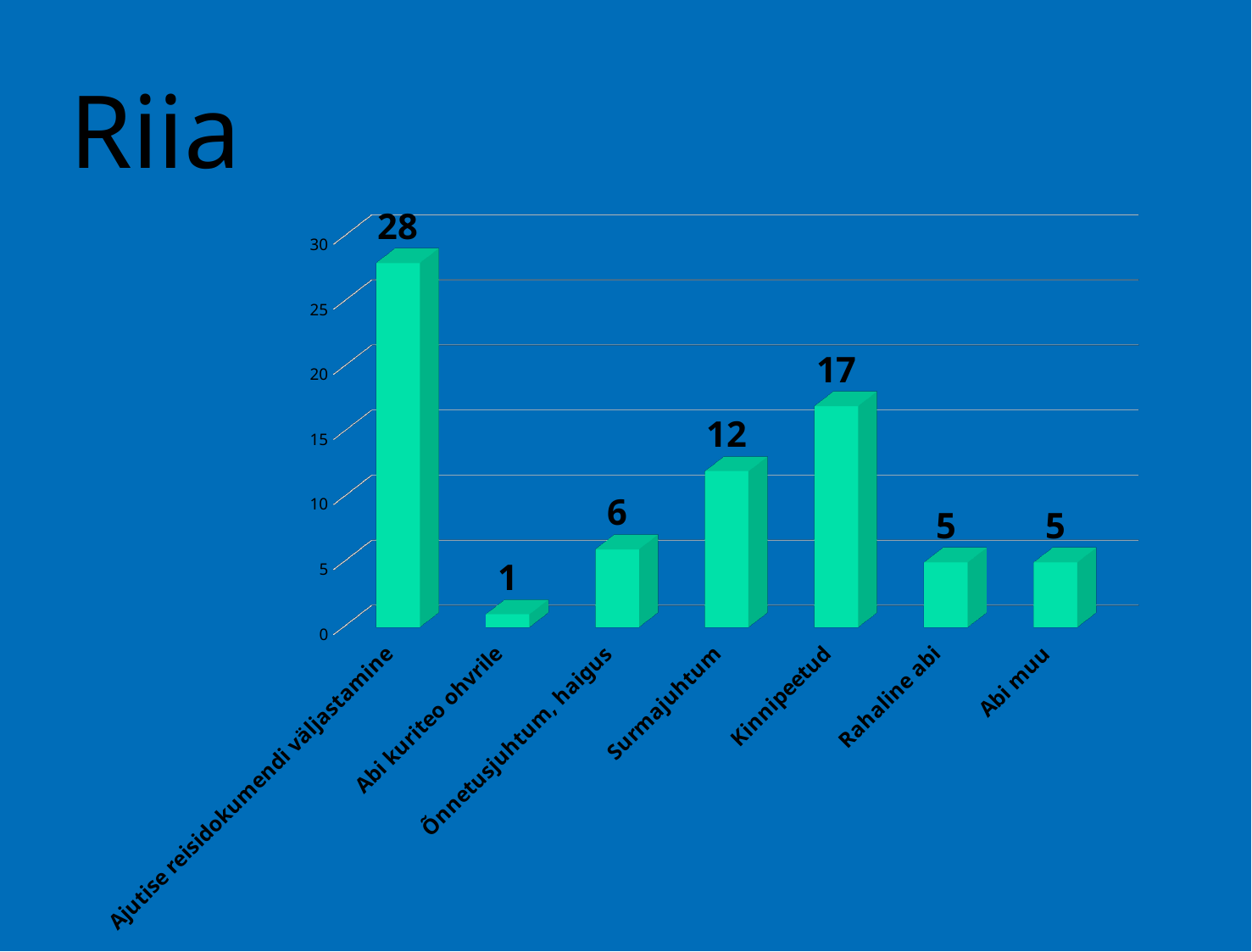
What is the value for Kinnipeetud? 17 How many categories are shown on the chart? 7 Which category has the lowest value? Abi kuriteo ohvrile What is the title of the slide? Riia What kind of chart is shown on the slide? bar chart What is the value for Ajutise reisidokumendi väljastamine? 28 What is the value for Surmajuhtum? 12 What is the value for Abi kuriteo ohvrile? 1 What is the difference between the values for Surmajuhtum and Õnnetusjuhtum, haigus? 6 What is the difference between the values for Ajutise reisidokumendi väljastamine and Kinnipeetud? 11 Which is larger, the value for Kinnipeetud or the value for Surmajuhtum? Kinnipeetud Which category has the highest value? Ajutise reisidokumendi väljastamine